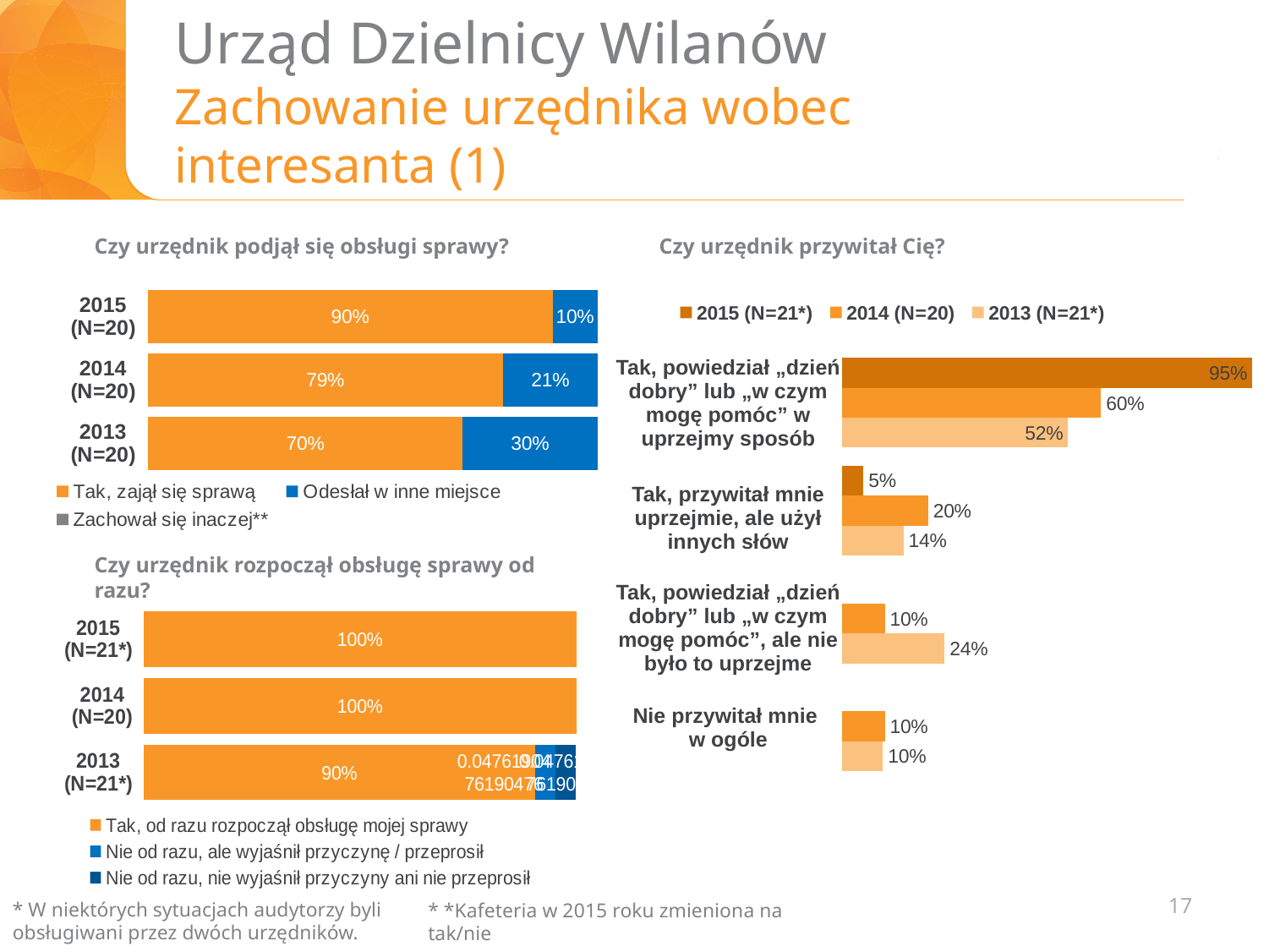
In the chart "Czy urzędnik przywitał Cię?", what is the 2013 (N=21*) value for "Tak, powiedział „dzień dobry” lub „w czym mogę pomóc”, ale nie było to uprzejme"? 24% What type of chart is "Czy urzędnik przywitał Cię?"? Bar chart In the chart "Czy urzędnik przywitał Cię?", what is the 2015 (N=21*) value for "Tak, powiedział „dzień dobry” lub „w czym mogę pomóc” w uprzejmy sposób"? 95% In the chart "Czy urzędnik podjął się obsługi sprawy?", how many series does the legend list? 3 In the chart "Czy urzędnik przywitał Cię?", how many response categories are shown? 4 In the chart "Czy urzędnik rozpoczął obsługę sprawy od razu?", what is the value of "Tak, od razu rozpoczął obsługę mojej sprawy" for 2013 (N=21*)? 90% In the chart "Czy urzędnik przywitał Cię?", which is larger for "Tak, przywitał mnie uprzejmie, ale użył innych słów": the 2014 (N=20) value or the 2013 (N=21*) value? 2014 (N=20) In the chart "Czy urzędnik podjął się obsługi sprawy?", what share of the 2015 (N=20) bar is "Tak, zajął się sprawą"? 90% In the chart "Czy urzędnik podjął się obsługi sprawy?", which year has the highest share of "Tak, zajął się sprawą"? 2015 (N=20) In the chart "Czy urzędnik podjął się obsługi sprawy?", what is the value of "Odesłał w inne miejsce" for 2013 (N=20)? 30% In the chart "Czy urzędnik podjął się obsługi sprawy?", what is the difference between the "Odesłał w inne miejsce" values for 2014 and 2015? 11 percentage points In the chart "Czy urzędnik rozpoczął obsługę sprawy od razu?", what is the value for 2014 (N=20)? 100%